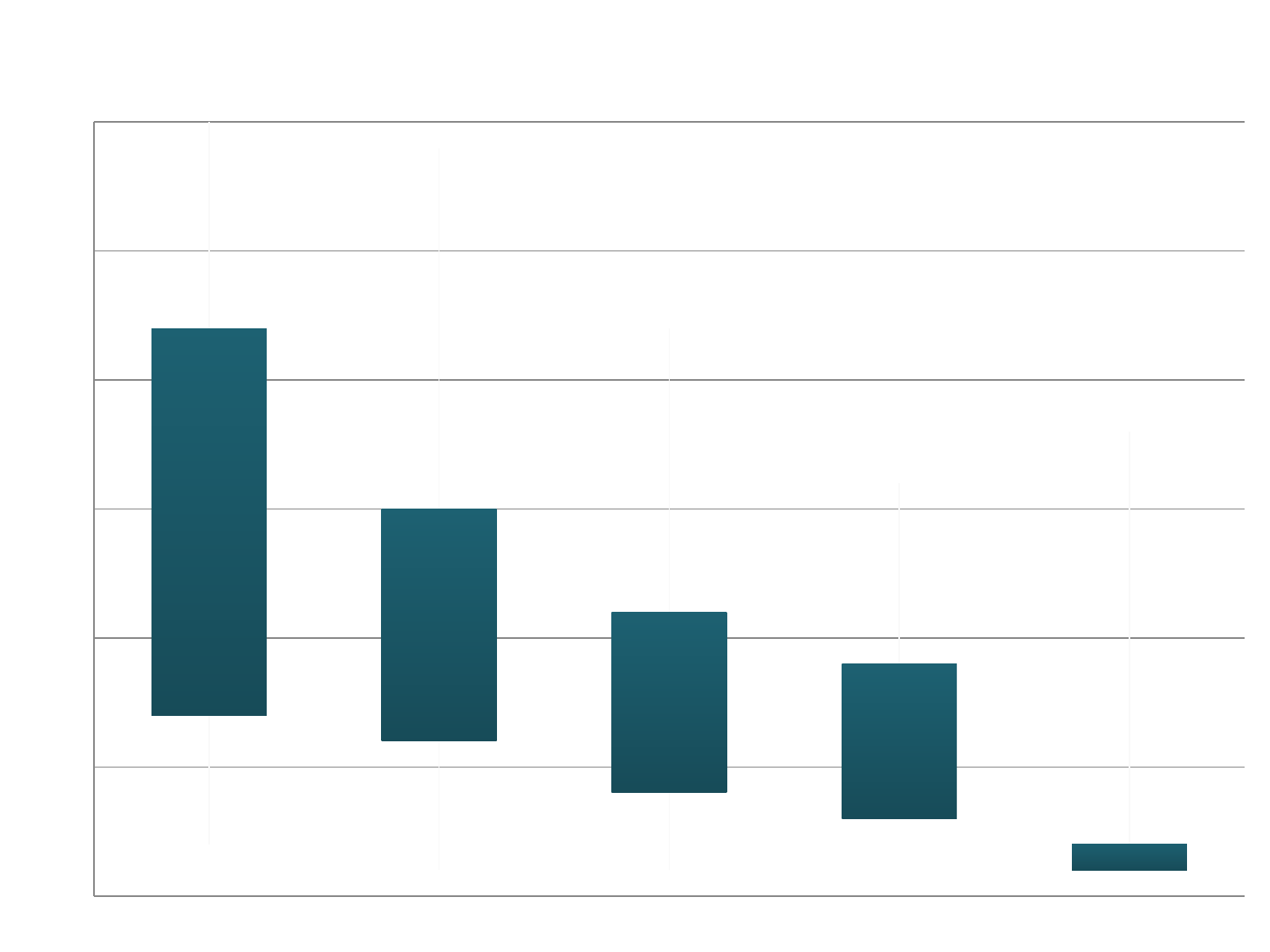
What kind of chart is shown on the slide? bar chart Is the leftmost bar taller or shorter than the second bar from the left? taller Which bar, by position, is the tallest in the chart? the leftmost bar Are the bars in the chart vertical or horizontal? vertical Which bar, by position, is the shortest in the chart? the rightmost bar What colour are the bars in the chart? dark teal How many bars are plotted in the chart? 5 Do the bars rise or fall from left to right along the x axis? fall Is the rightmost bar taller or shorter than the fourth bar from the left? shorter